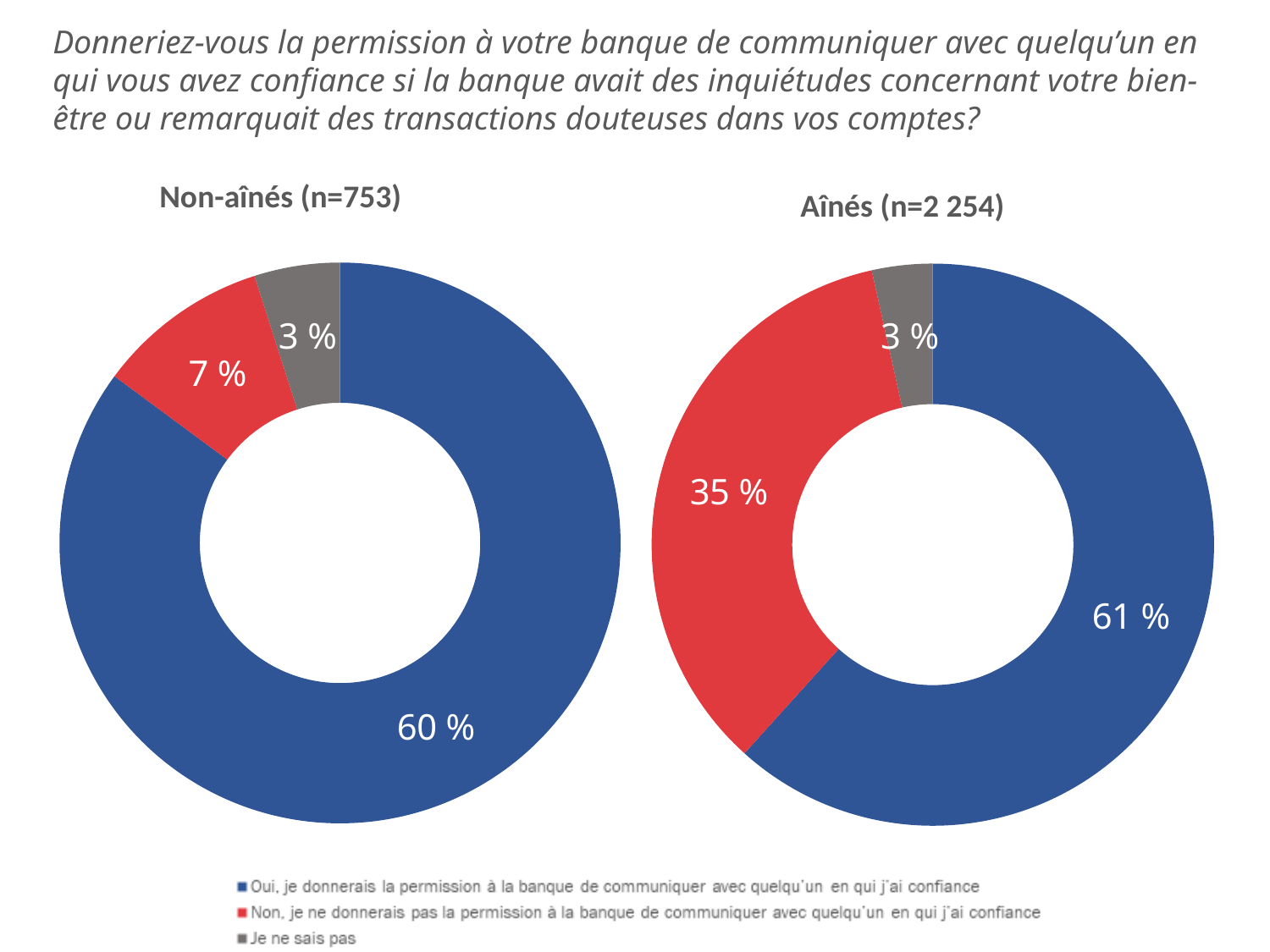
What kind of chart is used for 'Non-aînés (n=753)'? Pie chart (donut) How many slices does the 'Aînés (n=2 254)' chart have? 3 How many entries does the legend list? 3 In the 'Aînés (n=2 254)' chart, what percentage answered 'Oui, je donnerais la permission à la banque de communiquer avec quelqu'un en qui j'ai confiance'? 61 % Which chart shows a larger share for 'Non, je ne donnerais pas la permission': 'Non-aînés (n=753)' or 'Aînés (n=2 254)'? Aînés (n=2 254) In the 'Non-aînés (n=753)' chart, what percentage answered 'Oui, je donnerais la permission à la banque de communiquer avec quelqu'un en qui j'ai confiance'? 60 % In the 'Non-aînés (n=753)' chart, what percentage answered 'Je ne sais pas'? 3 % In the 'Aînés (n=2 254)' chart, what percentage answered 'Non, je ne donnerais pas la permission à la banque de communiquer avec quelqu'un en qui j'ai confiance'? 35 % In the 'Non-aînés (n=753)' chart, which response has the largest share? Oui, je donnerais la permission à la banque de communiquer avec quelqu'un en qui j'ai confiance In the 'Aînés (n=2 254)' chart, which response has the smallest share? Je ne sais pas What is the difference between the 'Non' share in the 'Aînés (n=2 254)' chart and the 'Non' share in the 'Non-aînés (n=753)' chart? 28 % What colour represents 'Je ne sais pas' in the charts? Grey